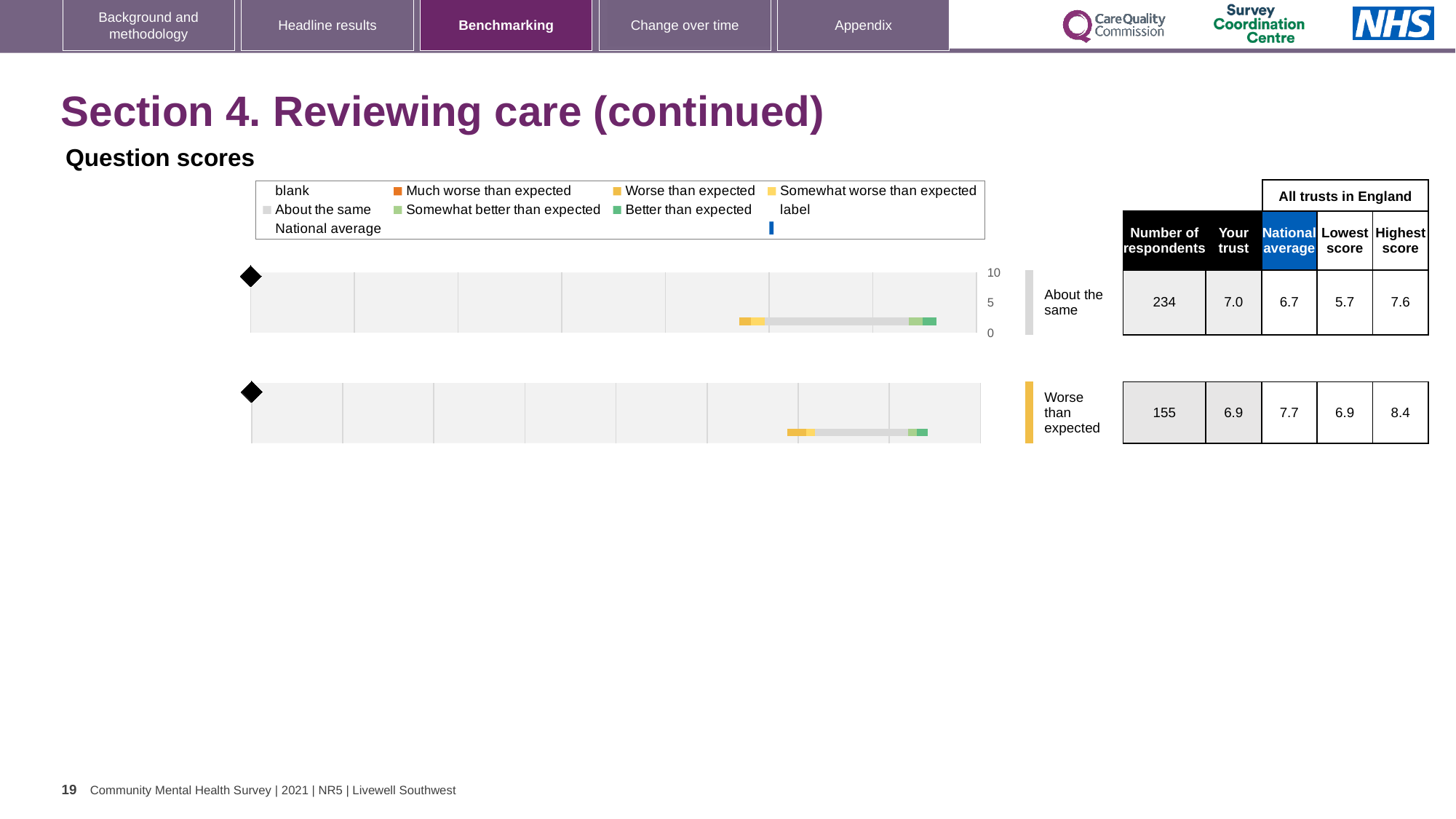
For the top chart (rated 'About the same'), what is the lowest score among all trusts in England? 5.7 For the bottom chart (rated 'Worse than expected'), what is the difference between the highest and lowest scores among all trusts in England? 1.5 For the top chart (rated 'About the same'), what is the difference between the 'Your trust' score and the national average? 0.3 For the bottom chart (rated 'Worse than expected'), which is larger: the 'Your trust' score or the national average? National average For the top chart (rated 'About the same'), what is the national average? 6.7 For the bottom chart (rated 'Worse than expected'), what is the highest score among all trusts in England? 8.4 How many question score charts are shown on the slide? 2 For the top chart (rated 'About the same'), what is the number of respondents shown in the table? 234 For the top chart (rated 'About the same'), what is the 'Your trust' score? 7.0 What kind of chart is used for the question scores on this slide? bar chart For the bottom chart (rated 'Worse than expected'), what is the 'Your trust' score? 6.9 What is the maximum value shown on the axis of the top chart? 10